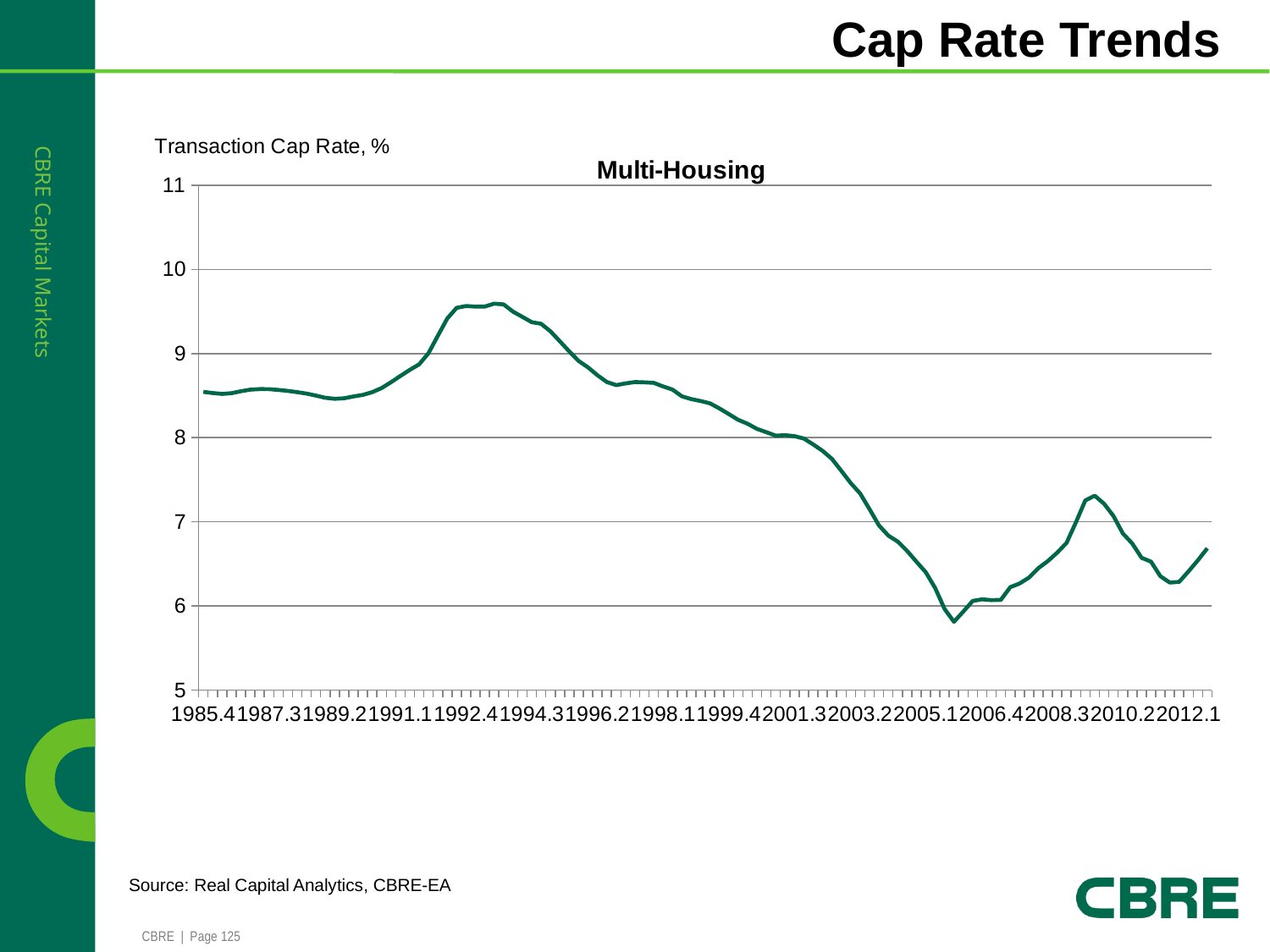
What quantity does the y axis of the chart measure, according to the label above it? Transaction Cap Rate, % Is the value at 2012.1 greater or less than 7? less How many period labels are printed along the x axis? 16 Between 1992.4 and 2005.1, does the cap rate generally rise or fall? fall What kind of chart is shown on the slide? line chart How many lines (series) are plotted on the chart? 1 What is the title of the chart? Multi-Housing Is the value at 1992.4 greater or less than 9? greater Is the value at 1985.4 greater or less than 8? greater